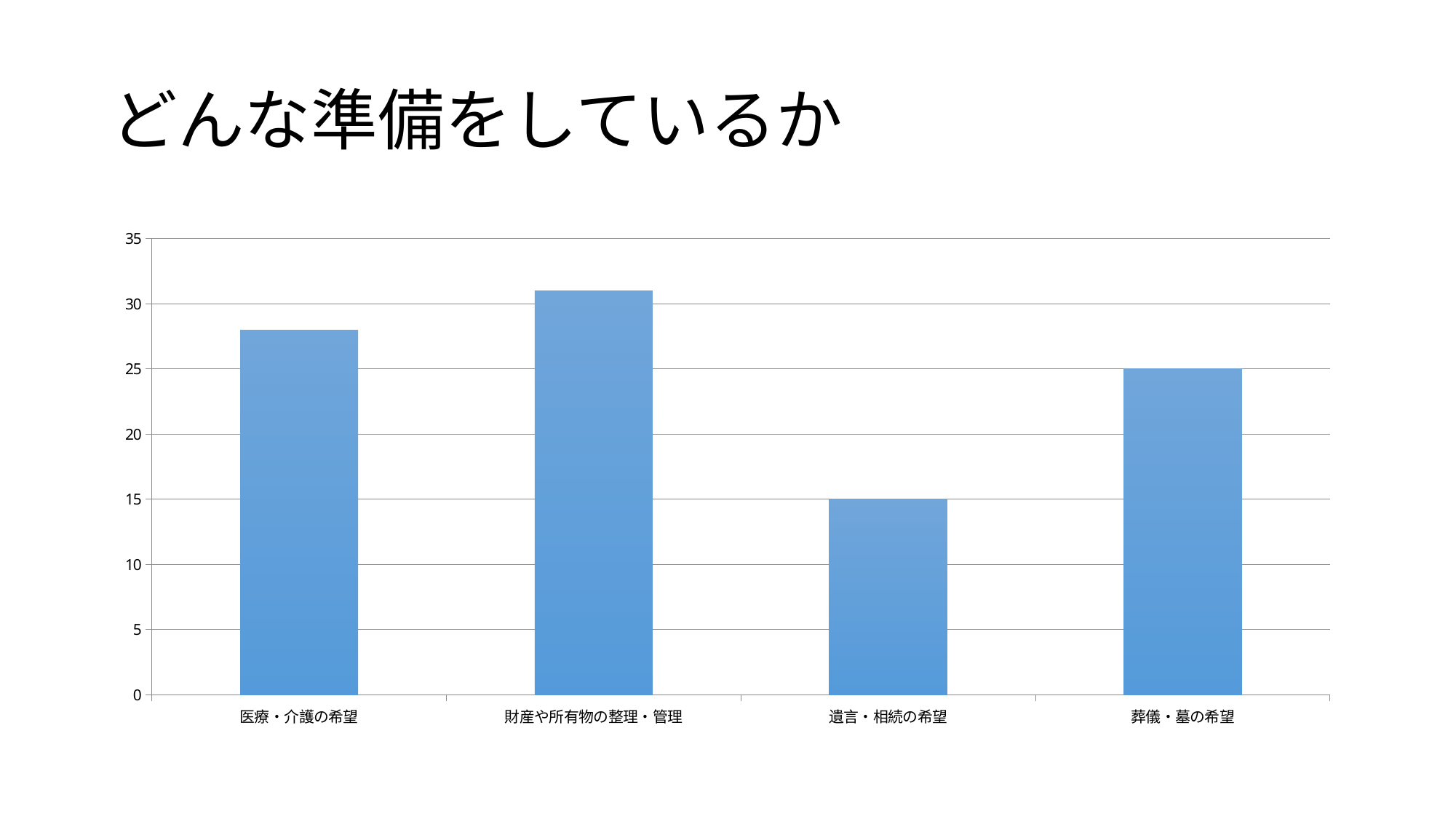
Which is larger, the value for 葬儀・墓の希望 or the value for 遺言・相続の希望? 葬儀・墓の希望 Is the value for 財産や所有物の整理・管理 greater or less than 30? greater How many categories are shown on the x axis of the chart? 4 What is the title of the slide containing the chart? どんな準備をしているか What type of chart is shown on the slide? bar chart What is the value for 遺言・相続の希望? 15 What is the value for 葬儀・墓の希望? 25 What is the difference between the values for 葬儀・墓の希望 and 遺言・相続の希望? 10 Which category has the highest value? 財産や所有物の整理・管理 Is the value for 医療・介護の希望 greater or less than 25? greater Which category has the lowest value? 遺言・相続の希望 Is the value for 医療・介護の希望 greater or less than 30? less